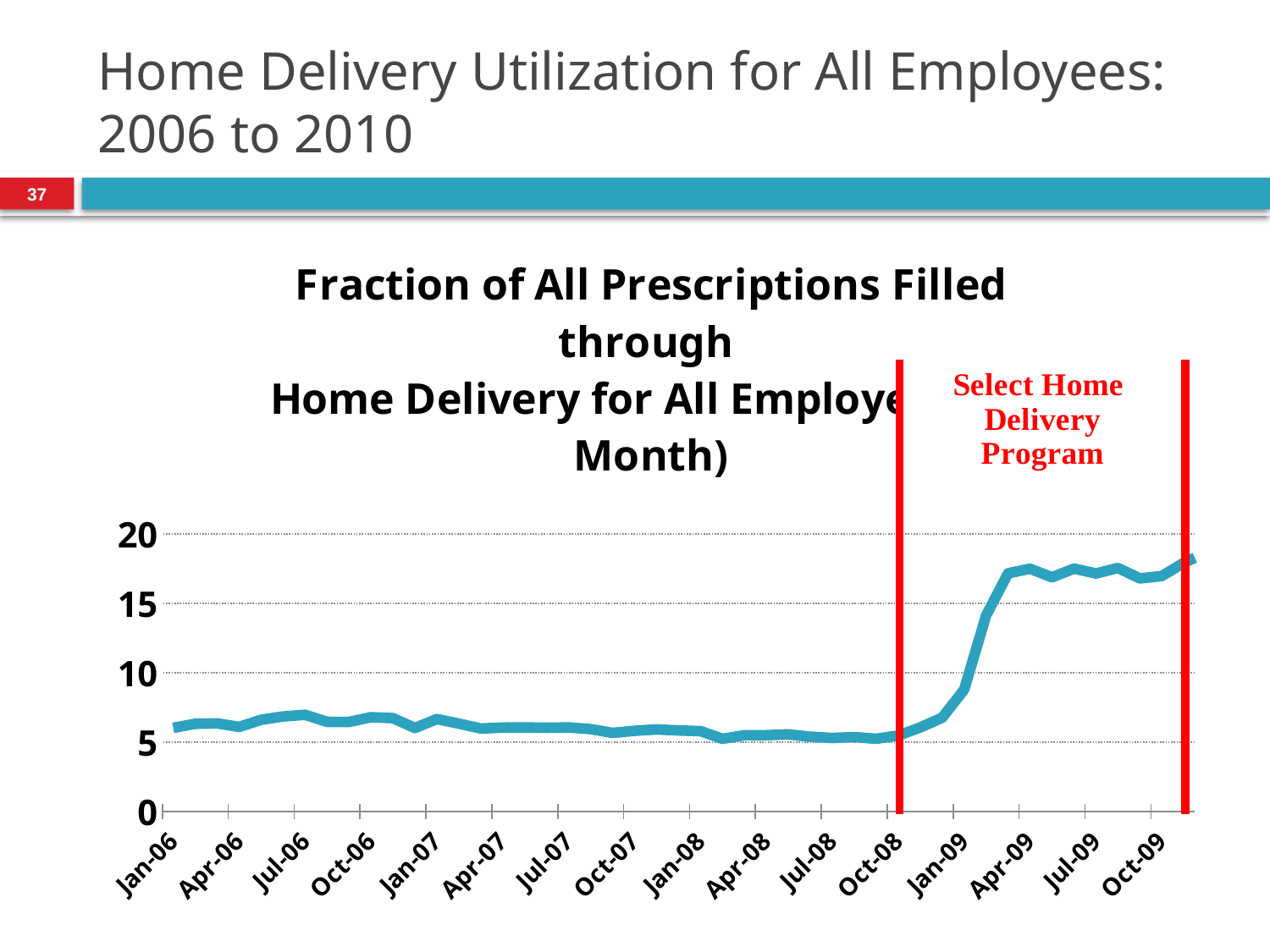
Is the value for Jul-08 greater or less than 10? less Is the value for Oct-09 greater or less than 15? greater How many month labels are shown on the x axis? 16 Is the value for Jan-09 greater or less than 10? less What is the highest tick value shown on the y axis? 20 What kind of chart is shown on the slide? line chart Which is larger, the value for Apr-08 or the value for Apr-09? Apr-09 Does the line rise or fall between Oct-08 and Apr-09? rise What text is written in red between the two vertical red lines? Select Home Delivery Program